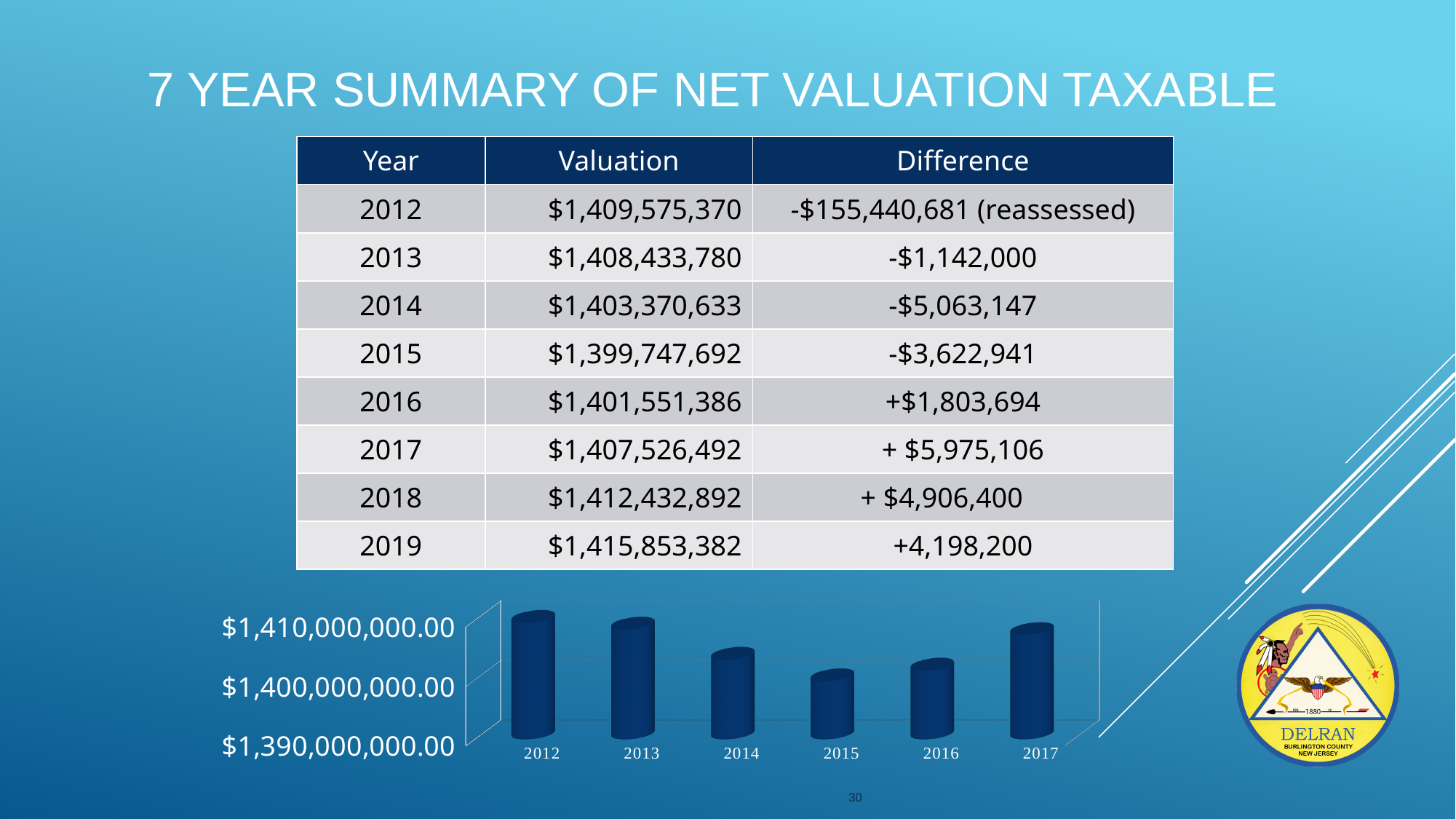
How many years are plotted as bars in the chart? 6 According to the table, what is the difference shown for 2017? + $5,975,106 What kind of chart is shown at the bottom of the slide? bar chart In the chart, which bar is taller, 2016 or 2017? 2017 What is the title of the slide? 7 Year Summary of Net Valuation Taxable In the chart, which bar is taller, 2014 or 2015? 2014 How do the bar values change from 2012 to 2015 in the chart? they fall Which year has the lowest bar in the chart? 2015 According to the table, what is the valuation for 2016? $1,401,551,386 In the chart, is the value for 2014 greater or less than $1,400,000,000.00? greater